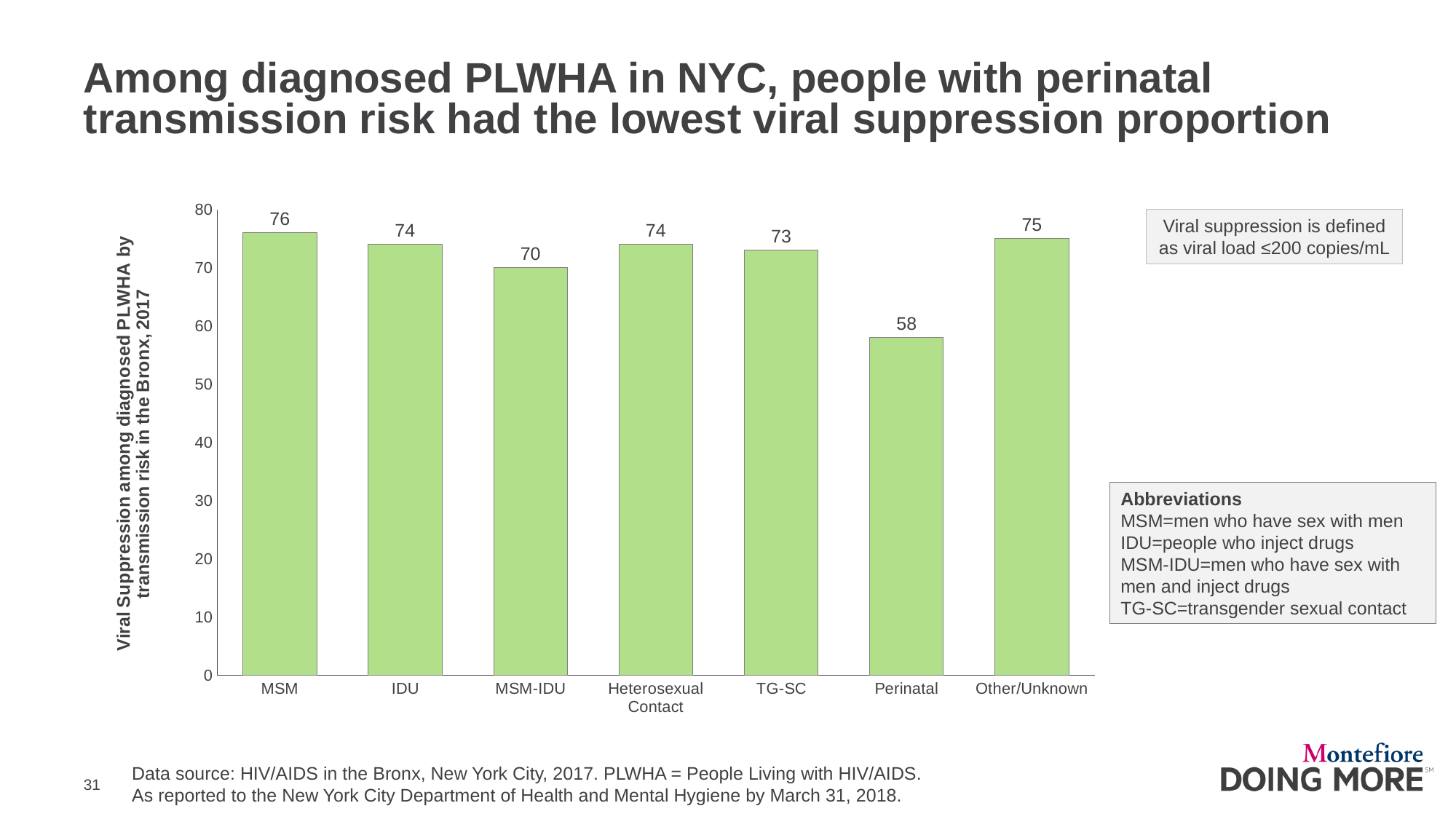
Is the value for Perinatal greater or less than 60? less What is the viral suppression value for Other/Unknown? 75 Which has a higher viral suppression value, TG-SC or Perinatal? TG-SC Which transmission risk category has the highest viral suppression value? MSM What is the viral suppression value for MSM-IDU? 70 What is the difference between the viral suppression values for MSM and Perinatal? 18 Which transmission risk category has the lowest viral suppression value? Perinatal What kind of chart is shown on the slide? bar chart What is the viral suppression value for Perinatal? 58 What is the viral suppression value for MSM? 76 How many transmission risk categories are shown on the x axis? 7 What is the label of the y axis? Viral Suppression among diagnosed PLWHA by transmission risk in the Bronx, 2017